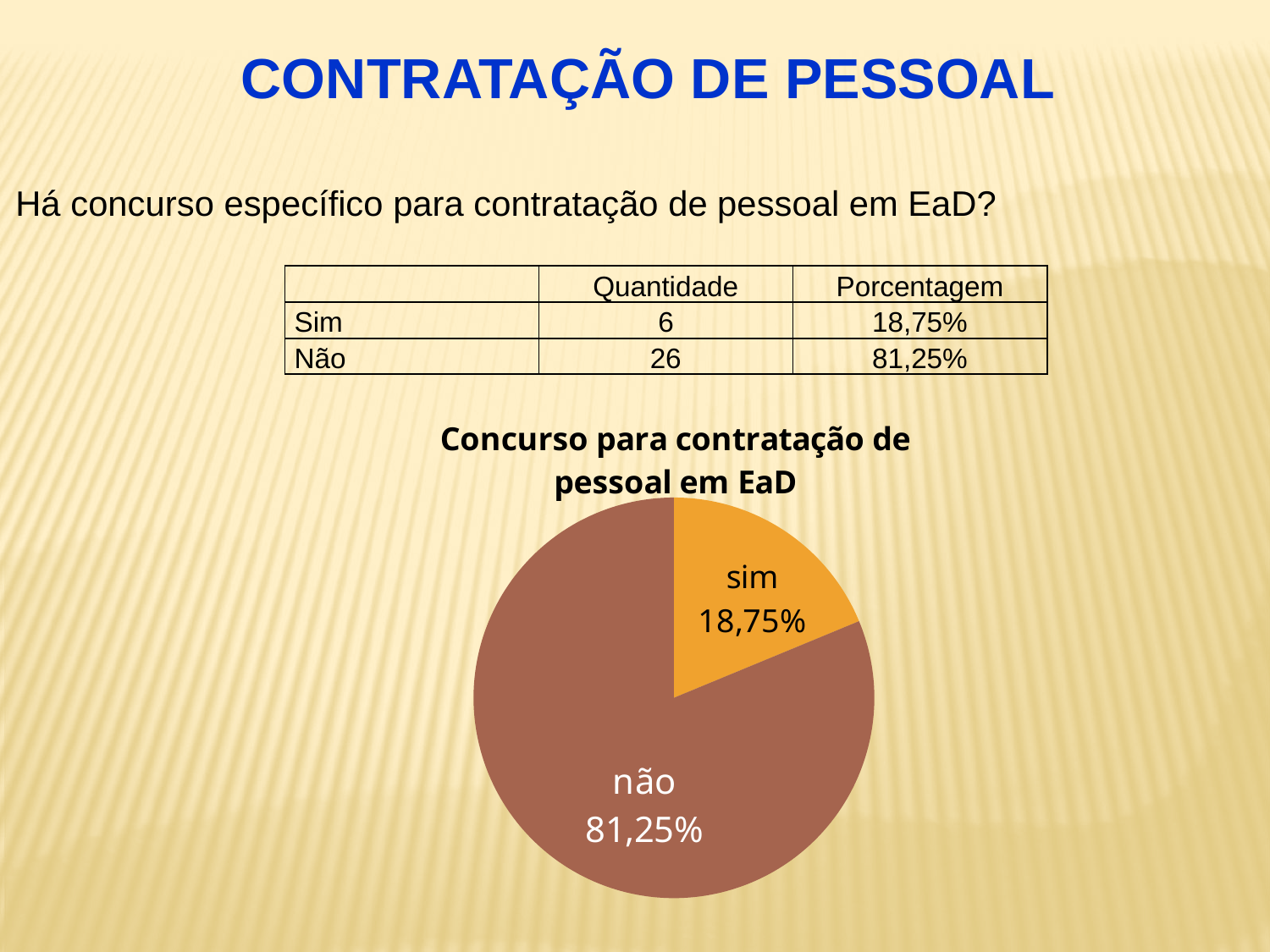
What kind of chart is shown on the slide? pie chart Which slice of the pie is the largest? não What share of the pie does the "não" slice represent? 81,25% What colour is the "sim" slice of the pie? orange What is the difference in percentage points between the "não" slice and the "sim" slice? 62,5 Which is larger, the "sim" slice or the "não" slice? não What share of the pie does the "sim" slice represent? 18,75% Which slice of the pie is the smallest? sim What is the title of the chart? Concurso para contratação de pessoal em EaD How many slices does the pie chart have? 2